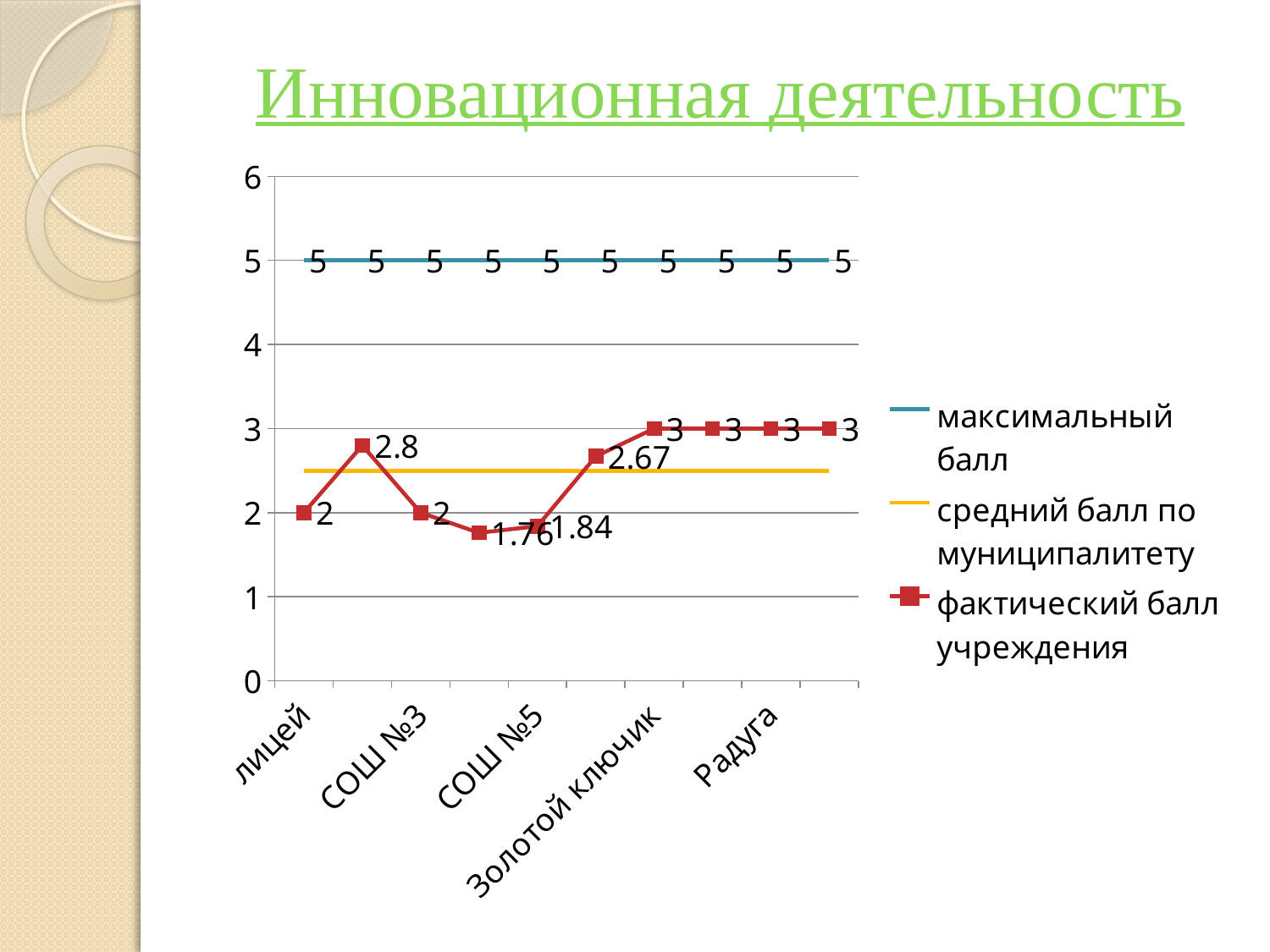
What is the title of the slide? Инновационная деятельность What is the difference between the фактический балл учреждения for Золотой ключик and for лицей? 1 What is the lowest value plotted on the фактический балл учреждения line? 1.76 How many data points are plotted on the фактический балл учреждения line? 10 How many series does the legend list? 3 What is the фактический балл учреждения for Золотой ключик? 3 What is the фактический балл учреждения for лицей? 2 What type of chart is shown on the slide? line chart What is the максимальный балл value for Радуга? 5 Is the средний балл по муниципалитету line greater or less than 3? less What is the фактический балл учреждения for СОШ №5? 1.84 Which has a higher фактический балл учреждения, СОШ №3 or Радуга? Радуга